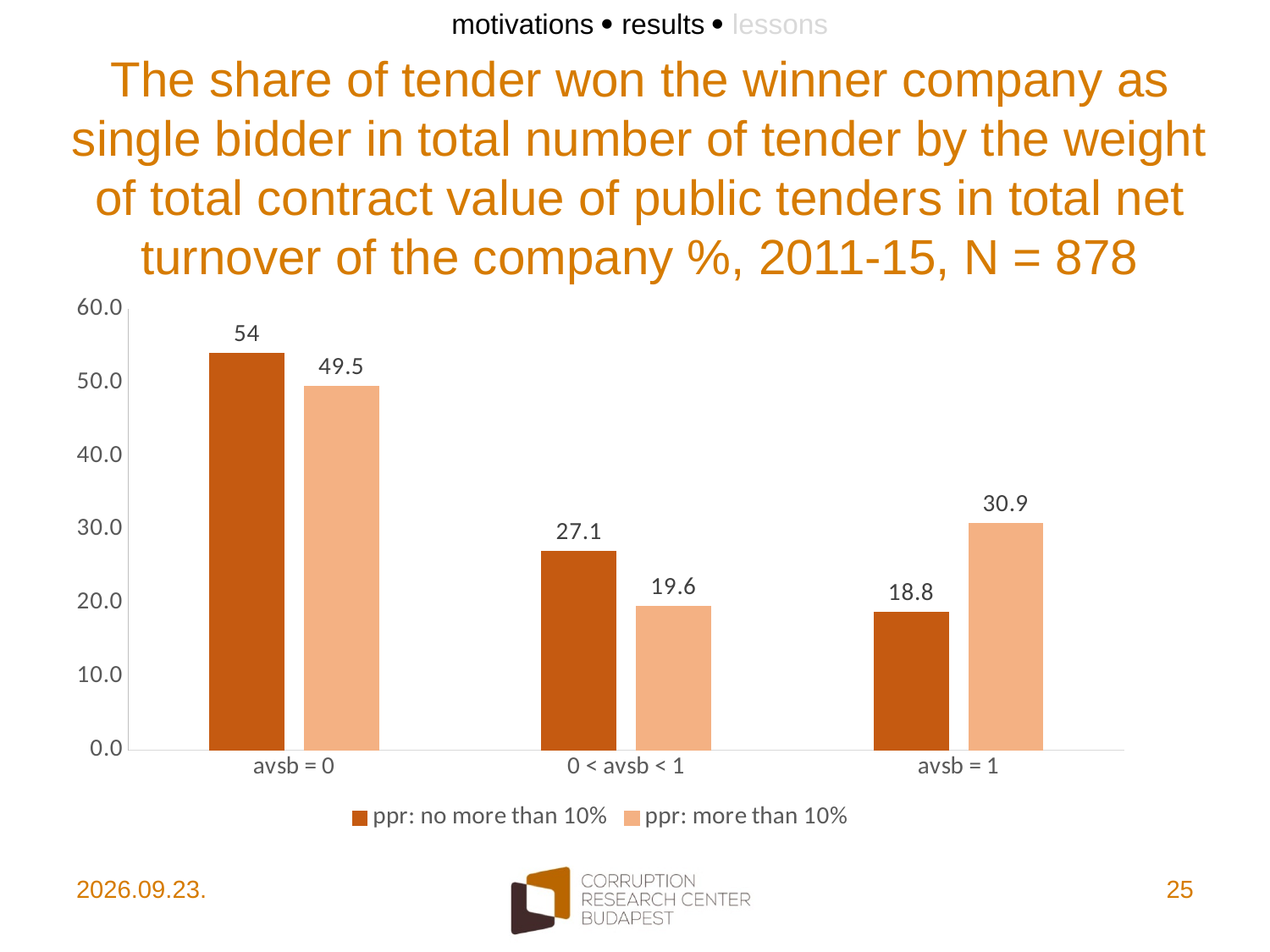
What is the difference between the two series at avsb = 1? 12.1 What is the value for 'ppr: more than 10%' at 0 < avsb < 1? 19.6 What is the difference between 'ppr: no more than 10%' and 'ppr: more than 10%' at avsb = 0? 4.5 How many categories are shown on the x axis? 3 How many series does the legend list? 2 Which category has the highest value for 'ppr: no more than 10%'? avsb = 0 Which category has the lowest value for 'ppr: more than 10%'? 0 < avsb < 1 At 0 < avsb < 1, which series has the larger value? ppr: no more than 10% What is the value for 'ppr: no more than 10%' at avsb = 0? 54 Does the value for 'ppr: no more than 10%' rise or fall across the categories from avsb = 0 to avsb = 1? fall What is the value for 'ppr: more than 10%' at avsb = 1? 30.9 What kind of chart is shown on the slide? bar chart